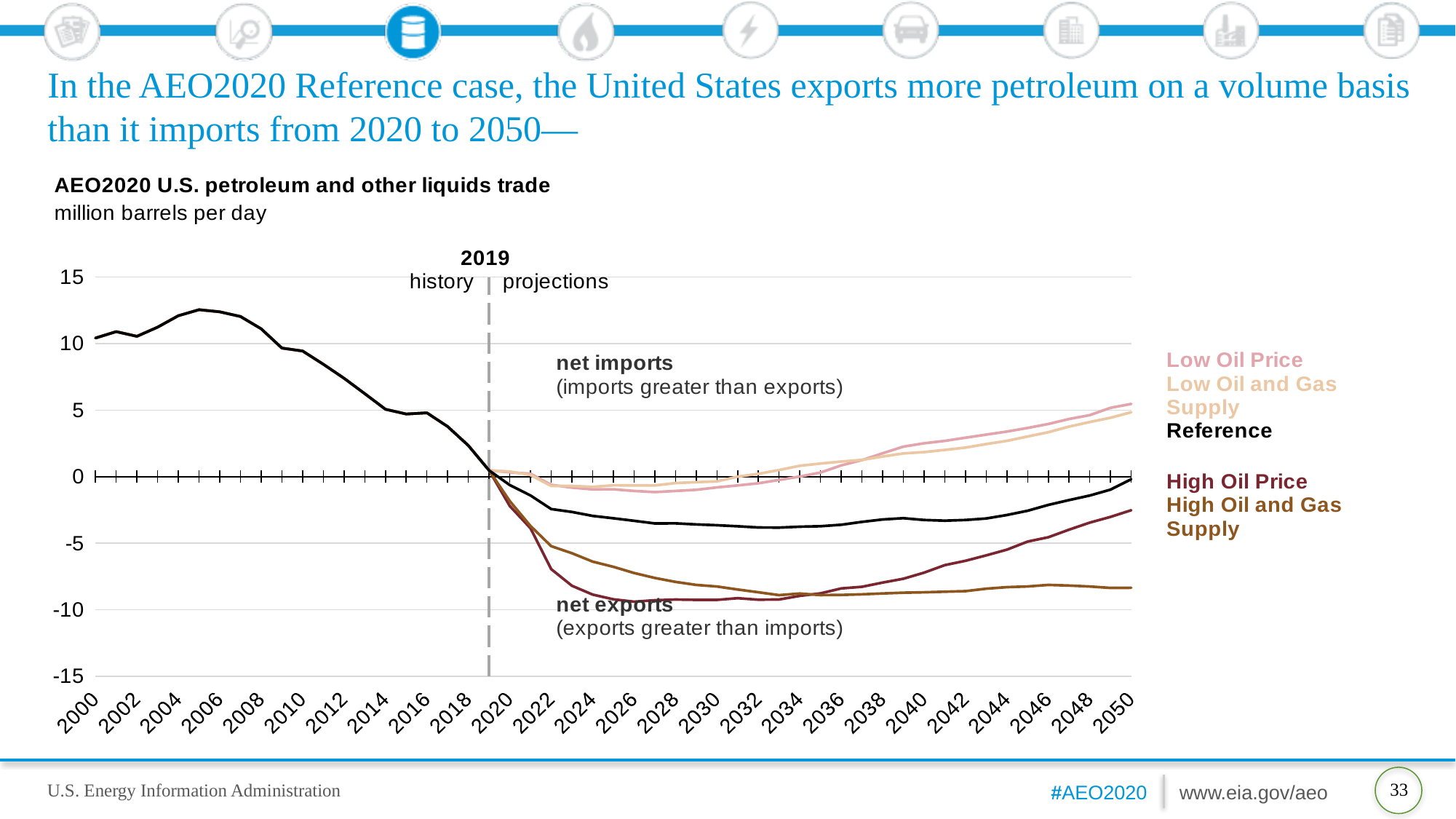
What unit is the y axis measured in? million barrels per day Does the Reference case line rise or fall from 2036 to 2050? rise Is the Reference case value in 2034 greater or less than 0? less What kind of chart is shown on the slide? line chart In 2024, which is larger: the High Oil Price value or the High Oil and Gas Supply value? High Oil and Gas Supply Does the historical line rise or fall from 2005 to 2019? fall How many scenario series does the legend list? 5 What is the title of the chart? AEO2020 U.S. petroleum and other liquids trade Which scenario has the lowest value in 2050? High Oil and Gas Supply Is the High Oil and Gas Supply value in 2050 greater or less than -5? less Is the historical value in 2005 greater or less than 10? greater